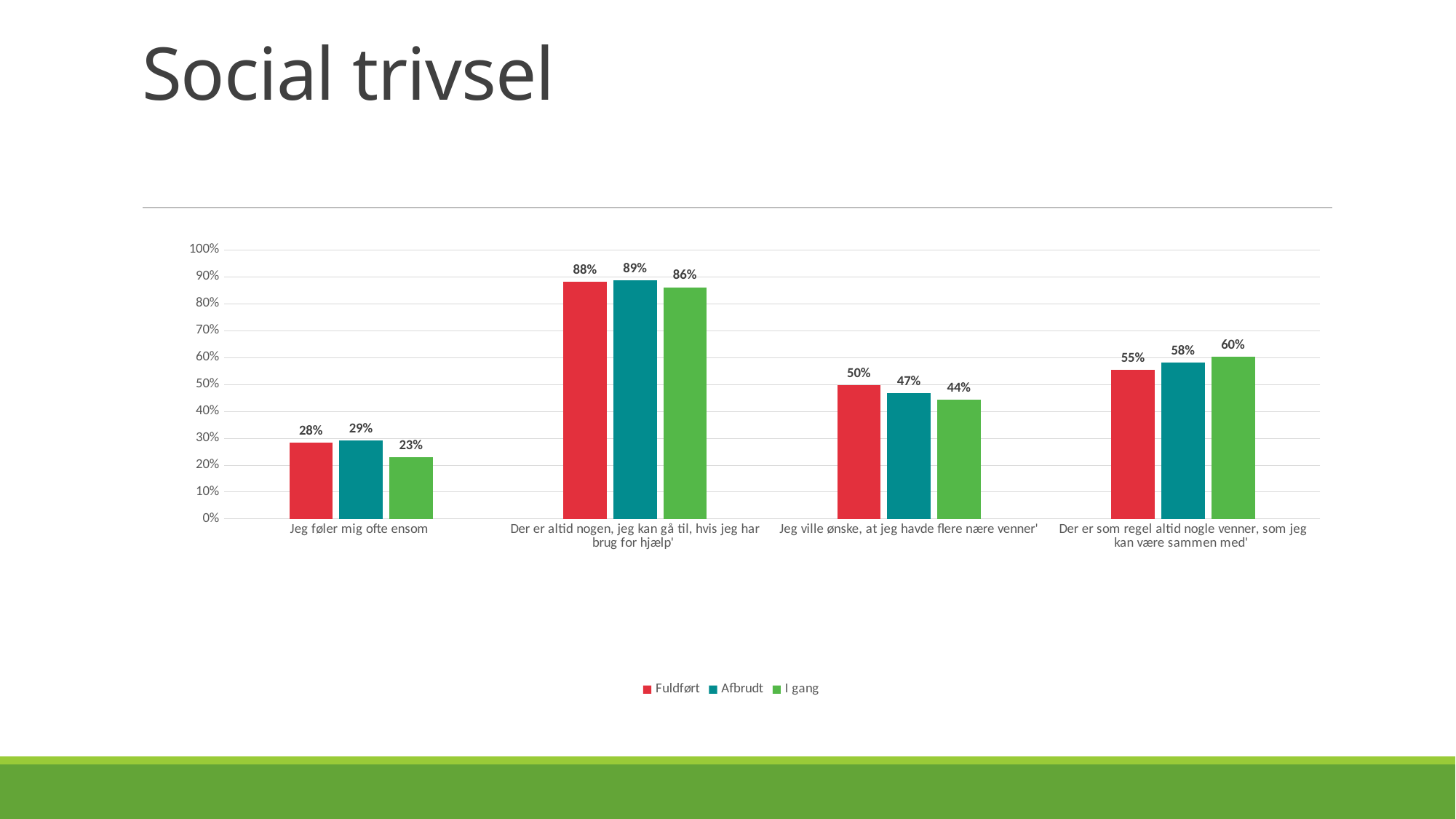
What is the value for I gang in the category 'Der er altid nogen, jeg kan gå til, hvis jeg har brug for hjælp'? 86% What kind of chart is shown on the slide? Bar chart Which category has the highest value for the Afbrudt series? Der er altid nogen, jeg kan gå til, hvis jeg har brug for hjælp What is the value for I gang in the category 'Der er som regel altid nogle venner, som jeg kan være sammen med'? 60% In the category 'Der er som regel altid nogle venner, som jeg kan være sammen med', which series has the larger value, Fuldført or I gang? I gang What is the difference between the Fuldført and I gang values in the category 'Jeg ville ønske, at jeg havde flere nære venner'? 6% What is the value for Afbrudt in the category 'Jeg ville ønske, at jeg havde flere nære venner'? 47% How many categories are shown on the x axis? 4 What is the value for Fuldført in the category 'Jeg føler mig ofte ensom'? 28% What is the title of the slide? Social trivsel How many series does the legend list? 3 Which category has the lowest value for the I gang series? Jeg føler mig ofte ensom